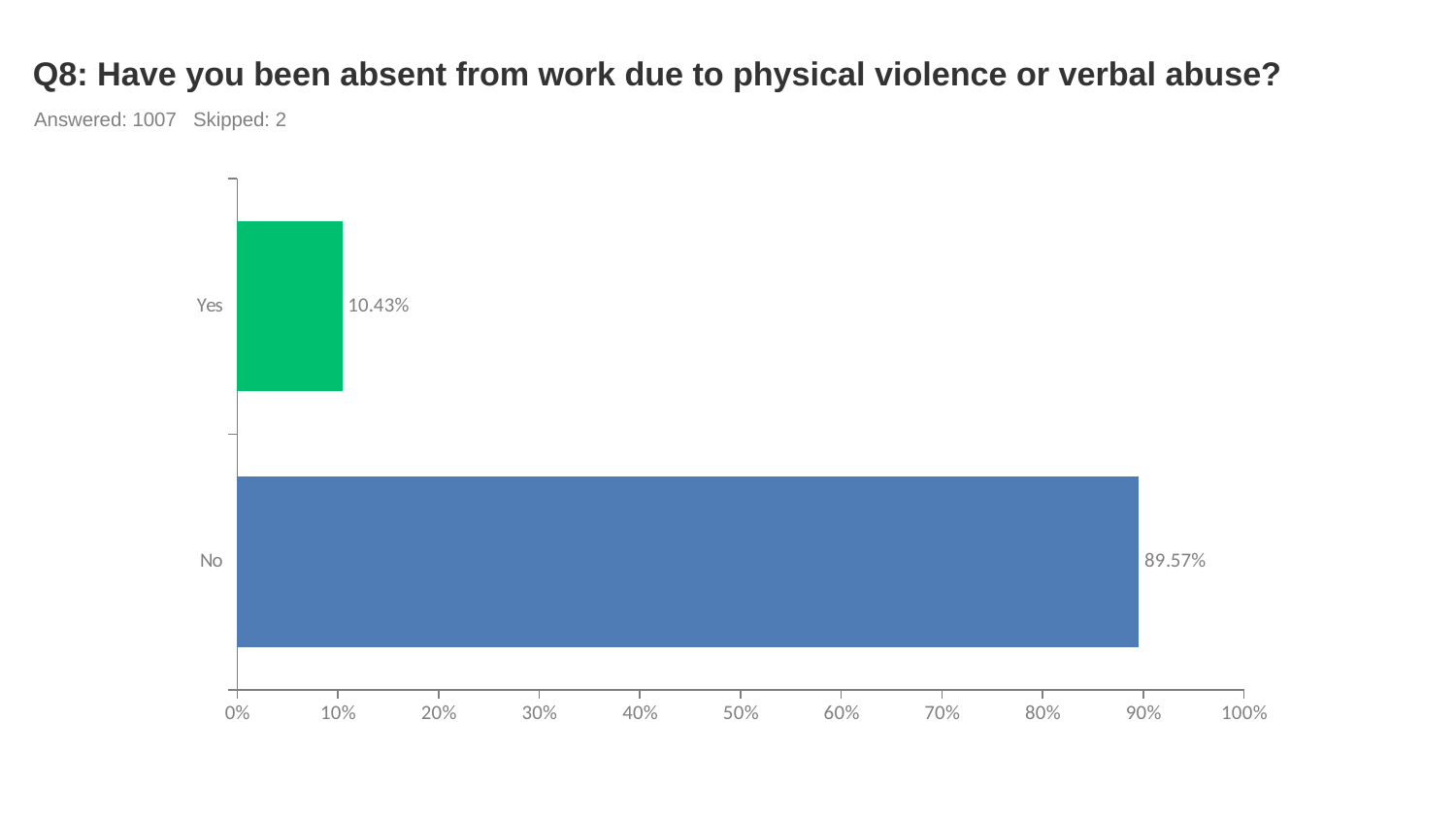
Which is larger, the value for Yes or the value for No? No Is the value for No greater or less than 80%? greater What is the difference in percentage points between the No and Yes responses? 79.14 What percentage of respondents answered Yes? 10.43% Which response category has the highest value? No How many respondents answered the question according to the slide? 1007 Which response category has the lowest value? Yes What kind of chart is shown on the slide? bar chart What percentage of respondents answered No? 89.57% What is the title of the chart? Q8: Have you been absent from work due to physical violence or verbal abuse? How many response categories are shown in the chart? 2 Is the value for Yes greater or less than 20%? less